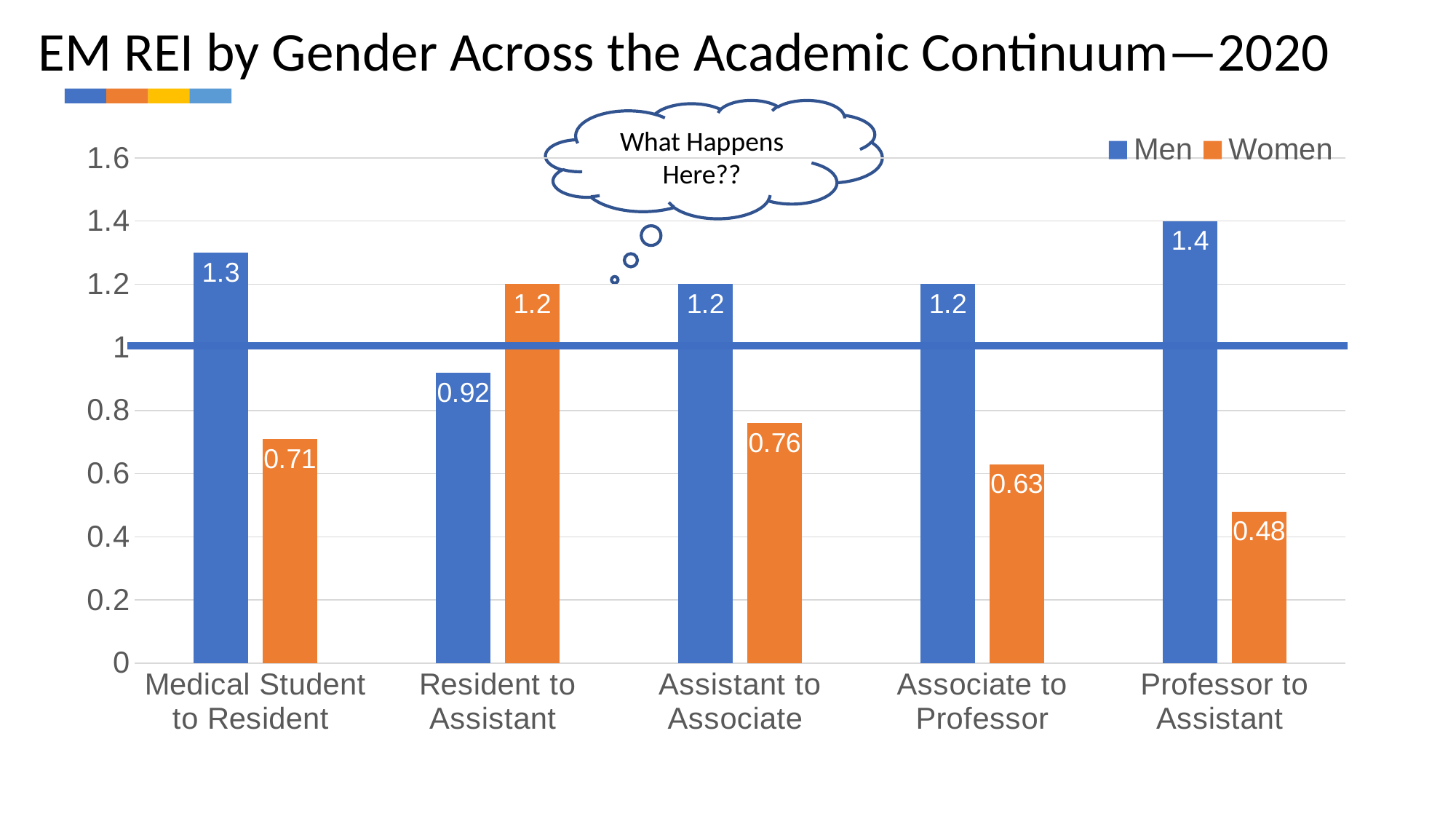
What kind of chart is shown on the slide? Bar chart How many series does the legend list? 2 What is the value for Men in the Medical Student to Resident category? 1.3 What is the difference between the Men and Women values in the Associate to Professor category? 0.57 What is the value for Women in the Professor to Assistant category? 0.48 What is the value for Men in the Resident to Assistant category? 0.92 What is the title of the chart? EM REI by Gender Across the Academic Continuum—2020 Which category has the lowest value for Women? Professor to Assistant What is the value for Women in the Resident to Assistant category? 1.2 In the Resident to Assistant category, which is larger, the Men value or the Women value? Women Which category has the highest value for Men? Professor to Assistant How many categories are shown on the x axis? 5